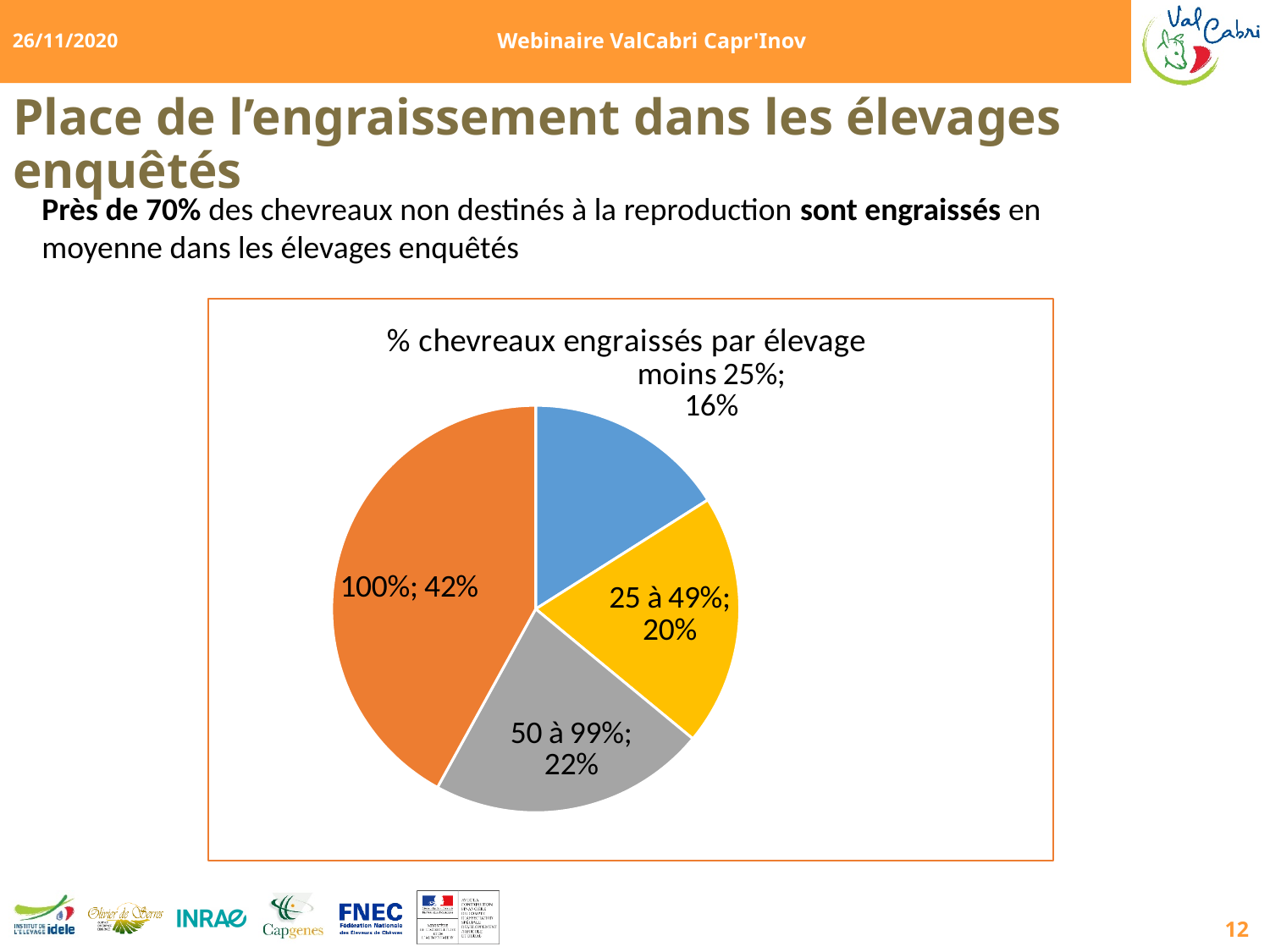
What share of the pie does the "25 à 49%" category represent? 20% Which category has the largest slice of the pie? 100% What colour is the slice for the "100%" category? orange What share of the pie does the "50 à 99%" category represent? 22% What is the title of the chart? % chevreaux engraissés par élevage How many slices does the pie chart have? 4 Which slice is larger, "25 à 49%" or "moins 25%"? 25 à 49% What share of the pie does the "moins 25%" category represent? 16% Which category has the smallest slice of the pie? moins 25% What kind of chart is shown on the slide? pie chart What is the difference in percentage points between the "100%" slice and the "50 à 99%" slice? 20